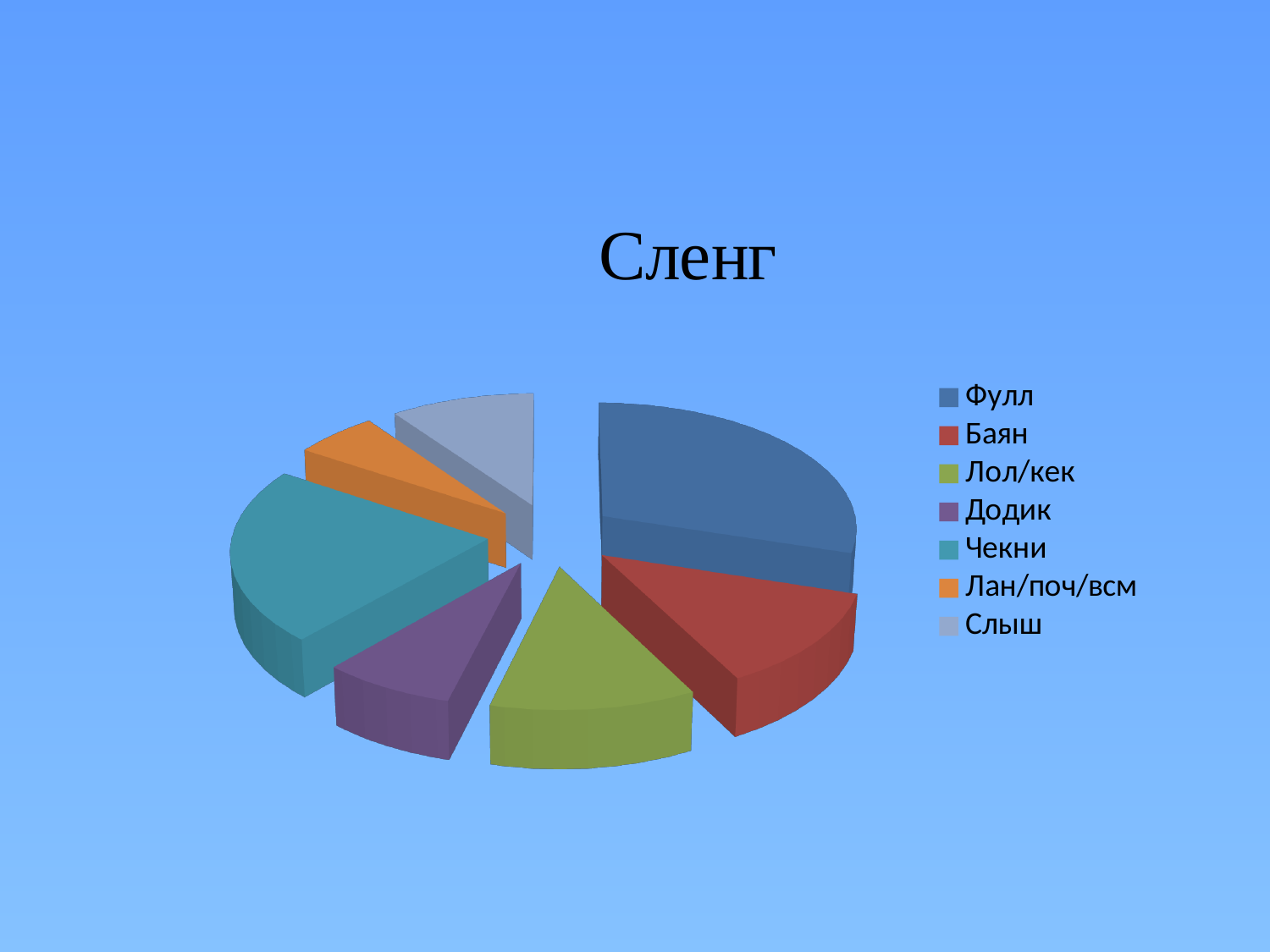
How many categories (slices) does the pie chart have? 7 Which slice is larger, Фулл or Додик? Фулл Which slice is larger, Баян or Лан/поч/всм? Баян Which slice is larger, Фулл or Лан/поч/всм? Фулл What is the title of the chart? Сленг Which category is shown in the blue slice? Фулл Which category is the last entry in the legend? Слыш What kind of chart is shown on the slide? pie chart